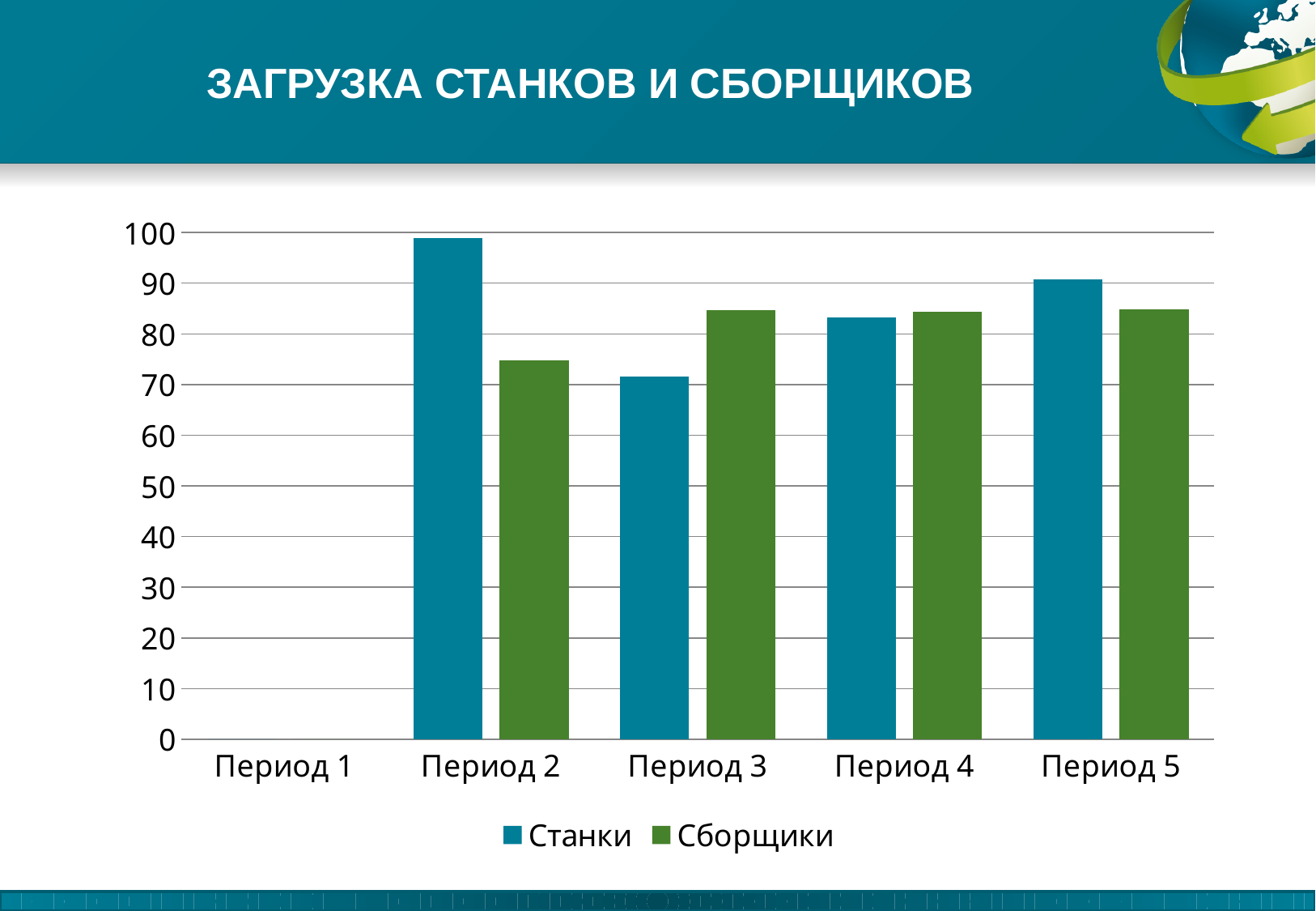
Is the value for Станки in Период 3 greater or less than 80? less Which series is shown in green in the legend? Сборщики Which is larger in Период 3: Станки or Сборщики? Сборщики Which is larger in Период 2: Станки or Сборщики? Станки What kind of chart is shown on the slide? bar chart Is the value for Станки in Период 2 greater or less than 90? greater Is the value for Сборщики in Период 2 greater or less than 80? less How many periods are shown on the x axis? 5 In which period is the value for Станки the highest? Период 2 In which period is the value for Станки the lowest (among periods with bars)? Период 3 In which period is the value for Сборщики the lowest (among periods with bars)? Период 2 How many series does the legend list? 2